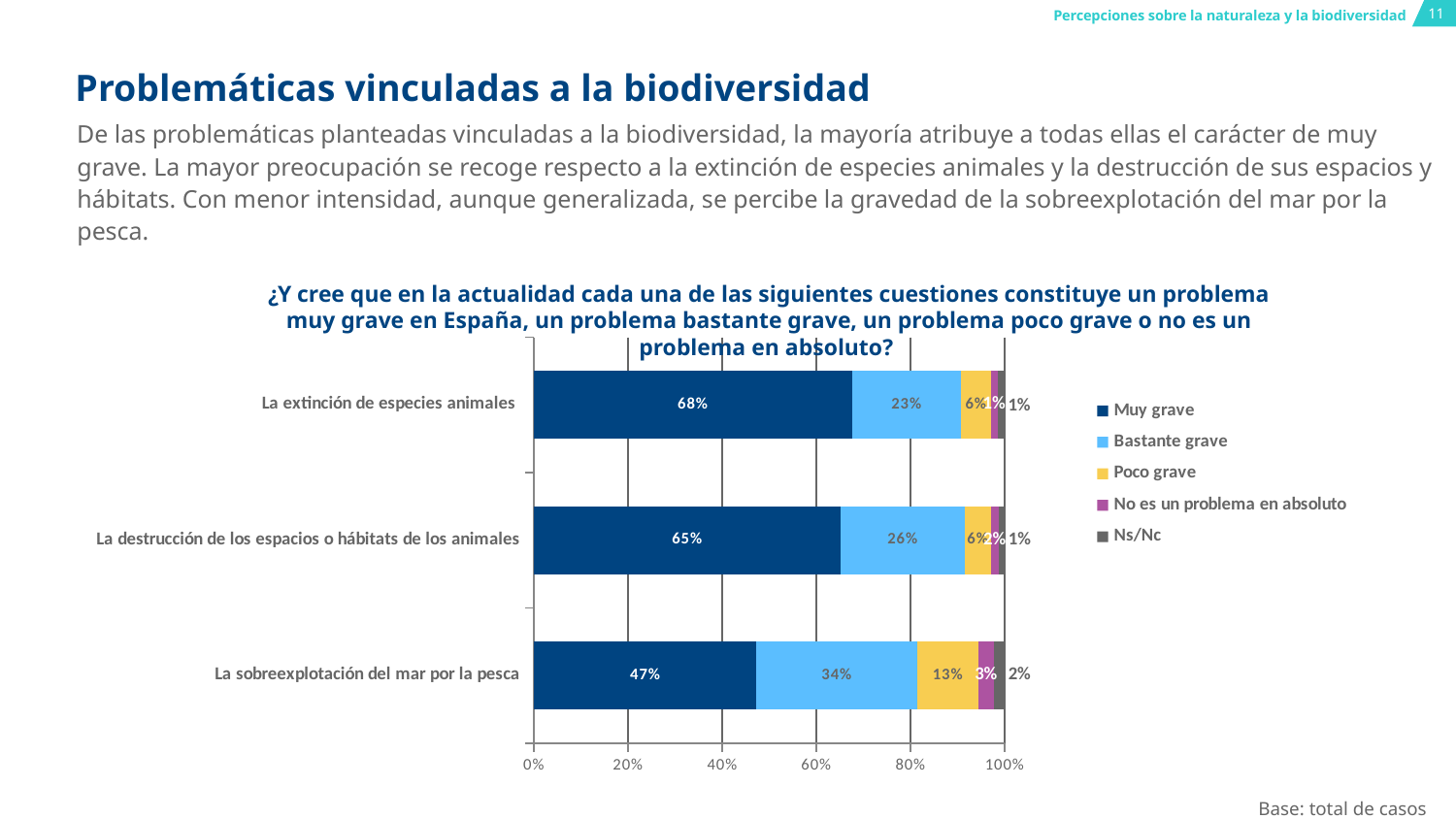
Which category has the highest 'Muy grave' percentage? La extinción de especies animales How many series does the legend list? 5 What is the difference between the 'Muy grave' values for 'La extinción de especies animales' and 'La sobreexplotación del mar por la pesca'? 21 percentage points How many categories (problems) are plotted in the chart? 3 What is the 'Ns/Nc' value for 'La sobreexplotación del mar por la pesca'? 2% What is the 'Poco grave' value for 'La destrucción de los espacios o hábitats de los animales'? 6% Which category has the lowest 'Muy grave' percentage? La sobreexplotación del mar por la pesca What is the 'Bastante grave' value for 'La sobreexplotación del mar por la pesca'? 34% Which is larger: the 'Poco grave' value for 'La sobreexplotación del mar por la pesca' or for 'La extinción de especies animales'? La sobreexplotación del mar por la pesca Which legend entry is shown in dark blue? Muy grave What kind of chart is shown on the slide? Stacked bar chart What percentage of respondents consider 'La extinción de especies animales' a 'Muy grave' problem? 68%